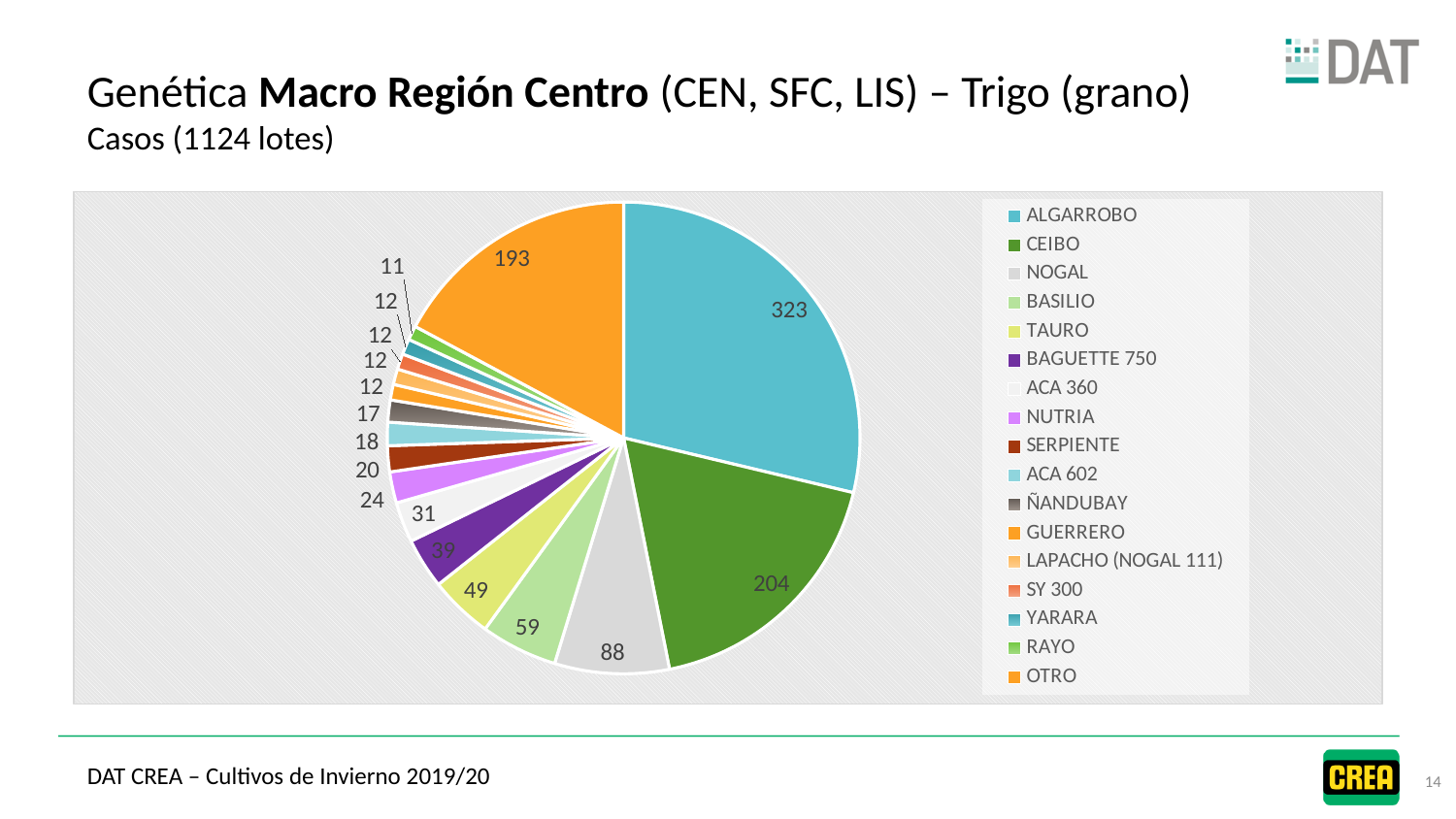
What is the value shown for NOGAL? 88 Which variety has the largest slice of the pie? ALGARROBO What is the value shown for CEIBO? 204 What is the value shown for the OTRO slice? 193 Which is larger, the slice for NOGAL or the slice for BASILIO? NOGAL What is the difference between the values for CEIBO and OTRO? 11 What is the subtitle shown under the slide title, indicating the number of cases? Casos (1124 lotes) What type of chart is shown on the slide? pie chart Which variety has the smallest slice of the pie? RAYO How many categories are listed in the chart legend? 17 What is the difference between the values for ALGARROBO and CEIBO? 119 How many cases (lotes) does the ALGARROBO slice represent? 323